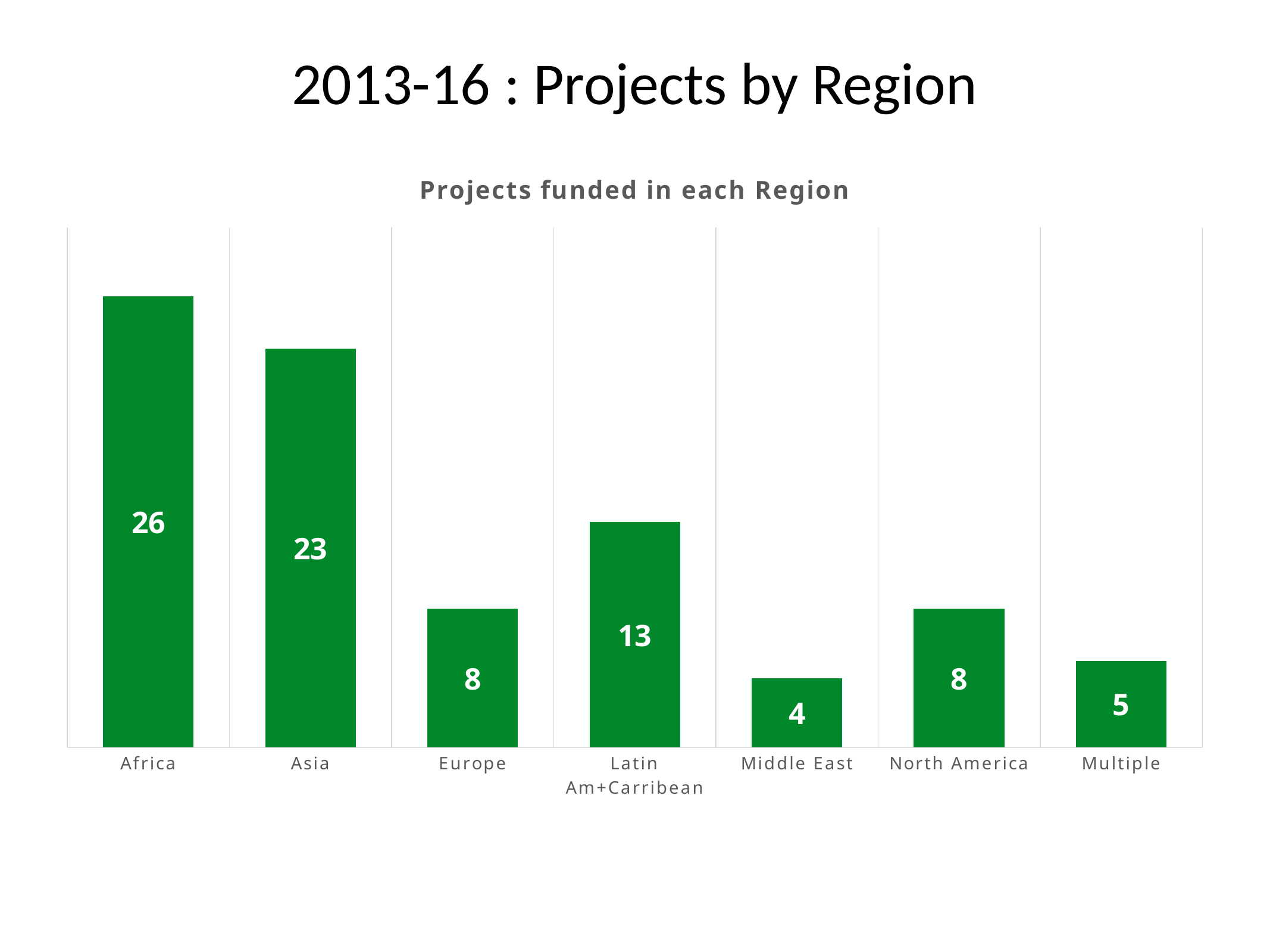
Which region has the lowest number of projects funded? Middle East Which has more projects funded, Asia or Latin Am+Carribean? Asia What is the difference between the number of projects funded in Africa and in Asia? 3 What is the title of the chart? Projects funded in each Region Which region has the highest number of projects funded? Africa What is the value for Multiple? 5 How many projects were funded in Africa? 26 How many projects were funded in the Middle East? 4 How many regions are shown on the chart? 7 How many projects were funded in Latin Am+Carribean? 13 What kind of chart is shown on the slide? Bar chart What is the difference between the number of projects funded in Latin Am+Carribean and in Europe? 5